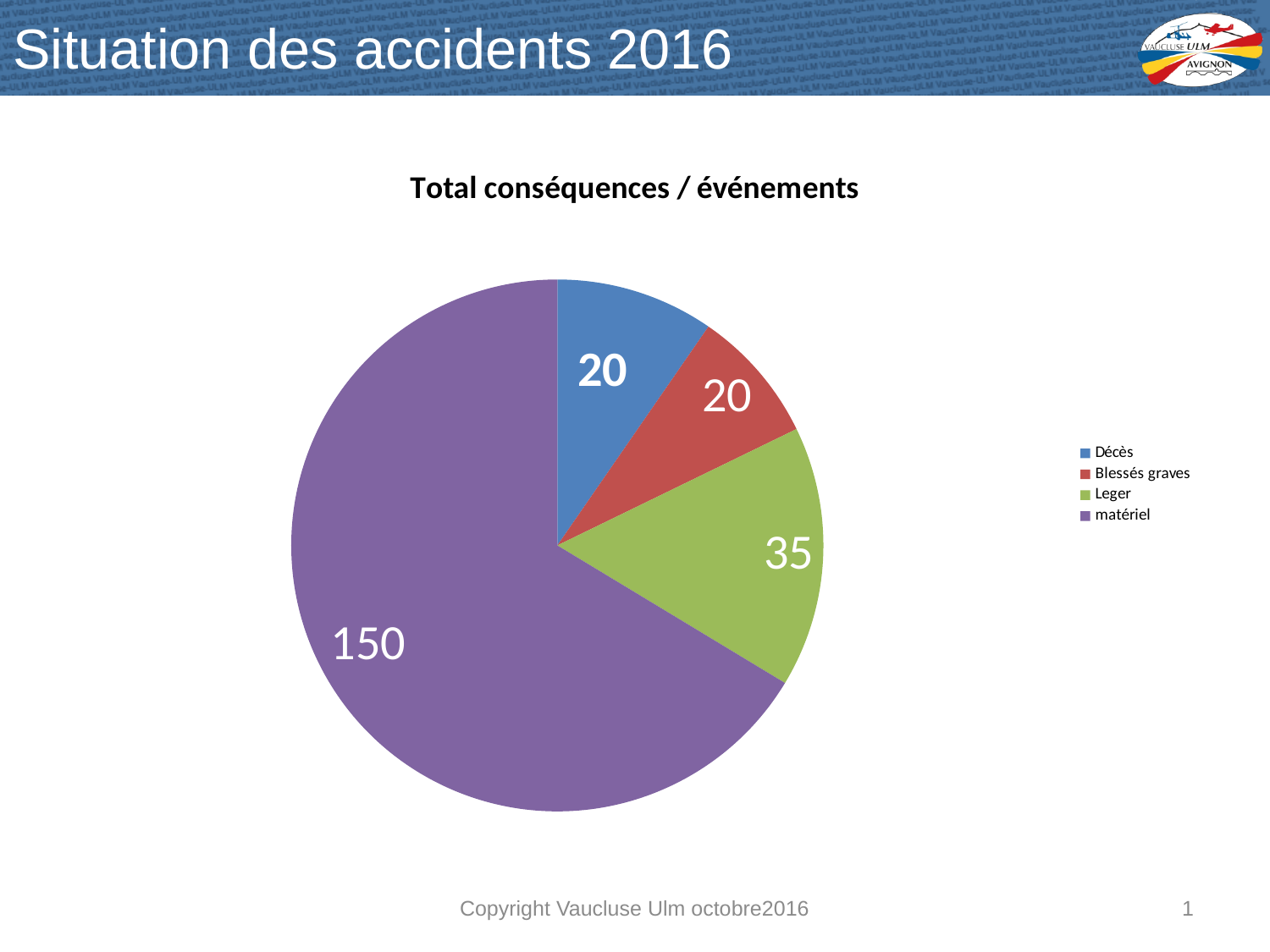
What is the value for matériel? 150 What is the title of the chart? Total conséquences / événements What type of chart is shown on the slide? pie chart What colour is the matériel slice? purple How many slices does the pie chart have? 4 What is the difference between the values for matériel and Leger? 115 What is the value for Leger? 35 What is the value for Décès? 20 What is the value for Blessés graves? 20 How many entries does the legend list? 4 Which is larger, the value for Leger or the value for Décès? Leger Which category has the largest slice of the pie? matériel